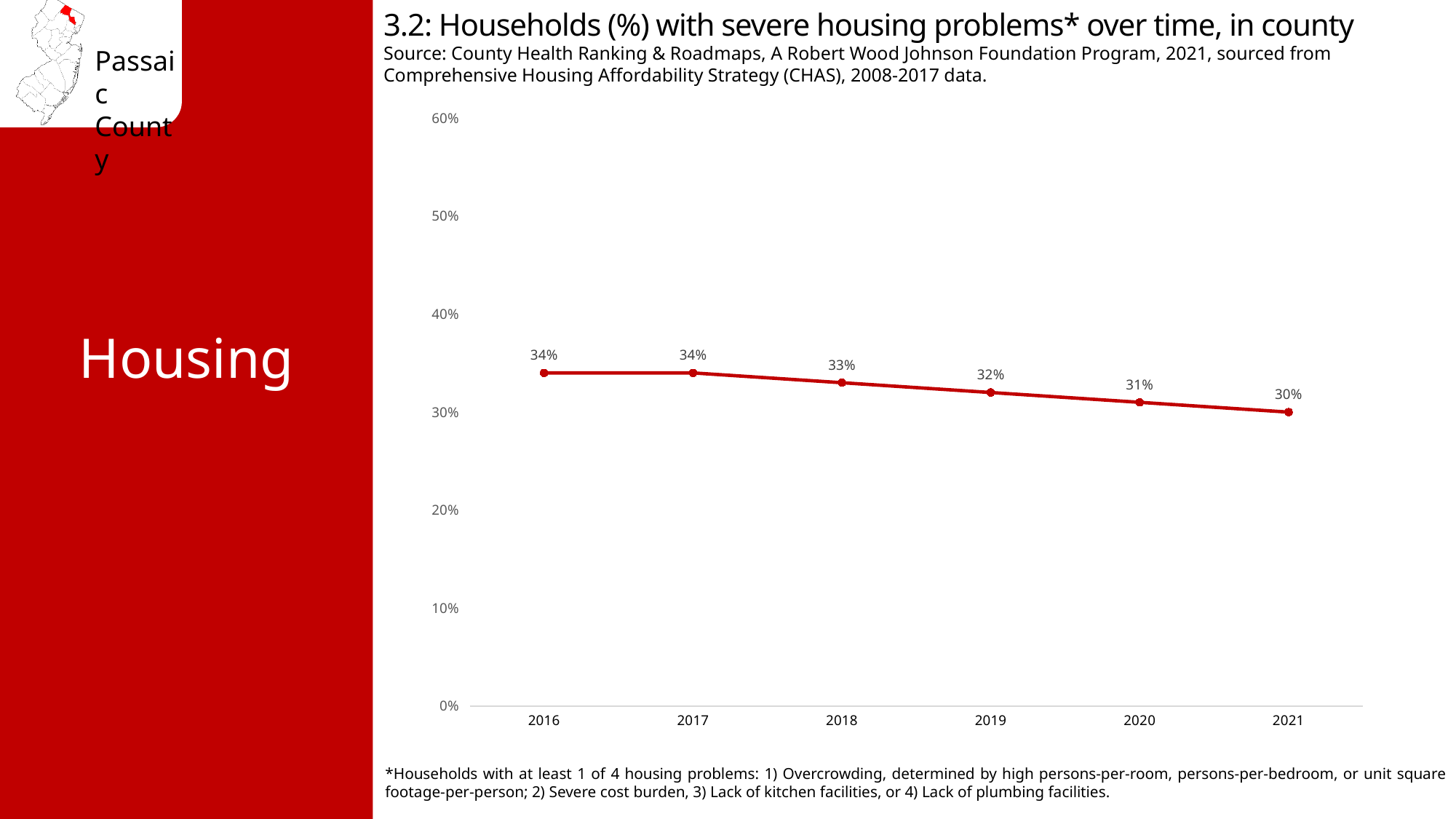
What is the title of the chart? 3.2: Households (%) with severe housing problems* over time, in county What is the difference between the 2016 value and the 2021 value? 4% What percentage of households had severe housing problems in 2021? 30% How many years are plotted on the chart? 6 What is the value shown for 2019? 32% What kind of chart is shown on the slide? line chart What percentage of households had severe housing problems in 2016? 34% Is the value for 2017 greater or less than 40%? less Which is larger, the value for 2018 or the value for 2020? 2018 Do the values rise or fall from 2016 to 2021? fall What is the difference between the 2018 value and the 2020 value? 2% Which year has the lowest percentage of households with severe housing problems? 2021